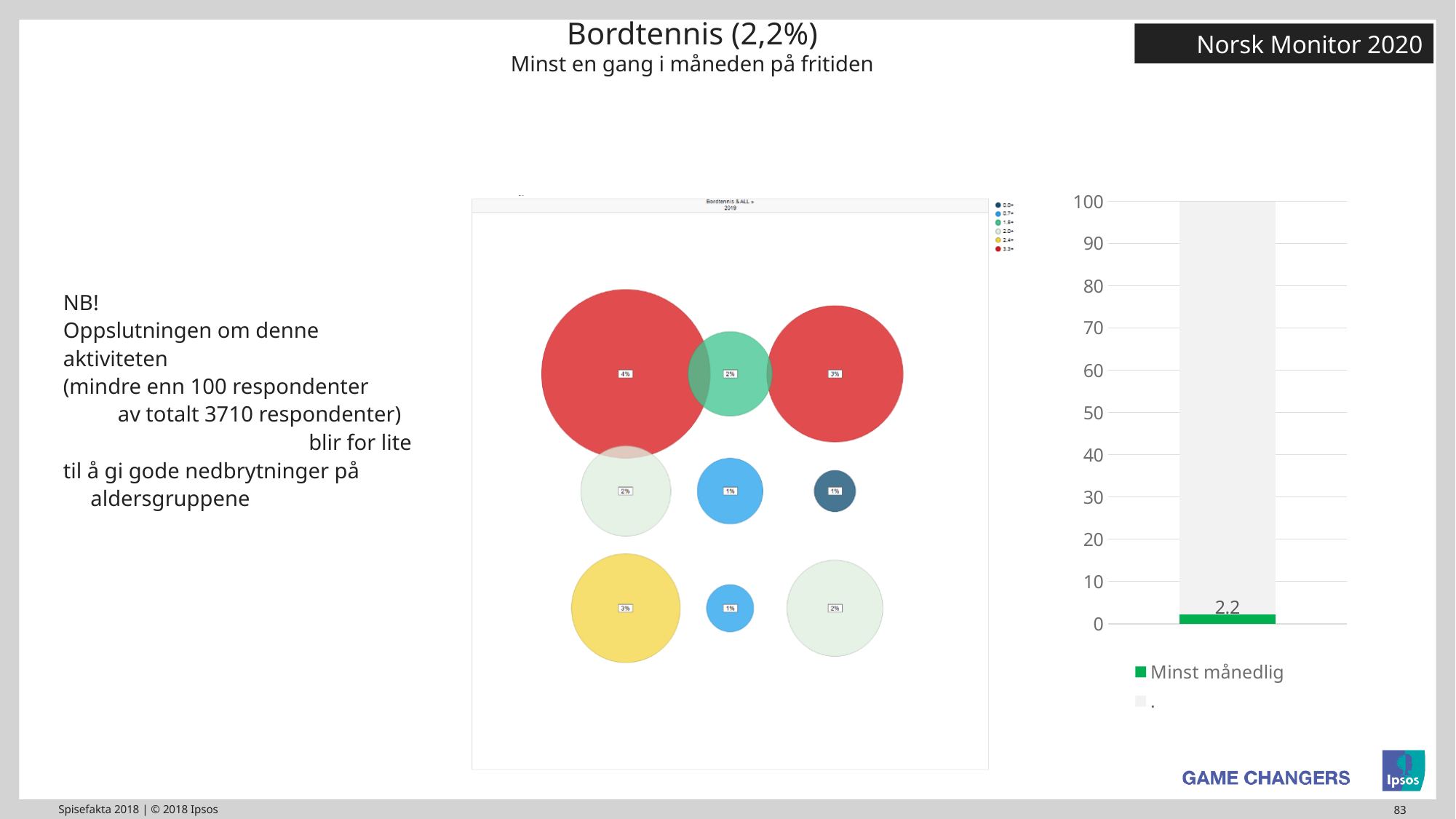
How many bubbles are plotted on the bubble chart in the middle of the slide? 9 On the bar chart on the right, what is the label of the green legend entry? Minst månedlig On the bar chart on the right, is the value for 'Minst månedlig' greater or less than 10? less On the bubble chart in the middle of the slide, what is the highest percentage printed on any bubble? 4% On the bubble chart in the middle of the slide, what percentage is printed on the large yellow bubble? 3% On the bubble chart in the middle of the slide, what is the lowest percentage printed on any bubble? 1% What kind of chart is the chart on the right of the slide? bar chart On the bar chart on the right, what value is printed on the green bar for 'Minst månedlig'? 2.2 On the bar chart on the right, what is the highest value shown on the vertical axis? 100 How many bars are plotted on the bar chart on the right? 1 How many entries does the legend of the bar chart on the right list? 2 What kind of chart is the chart in the middle of the slide with the coloured circles? bubble chart